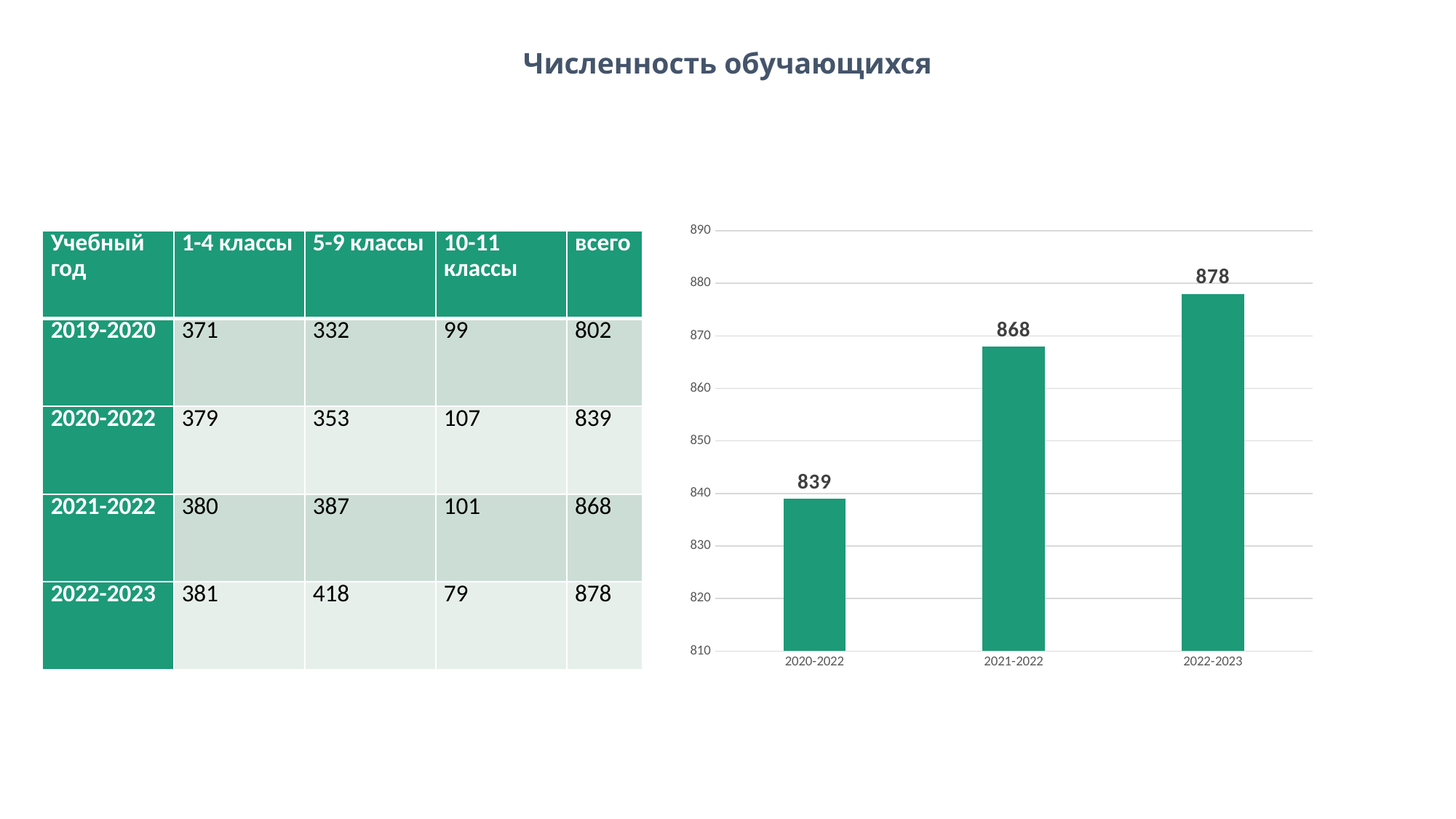
What is the value of the bar for 2022-2023 in the chart? 878 Do the values in the chart rise or fall from 2020-2022 to 2022-2023? rise Which category has the lowest bar in the chart? 2020-2022 What is the difference between the values for 2021-2022 and 2020-2022 in the chart? 29 What is the value of the bar for 2021-2022 in the chart? 868 Which is larger in the chart, the value for 2021-2022 or the value for 2022-2023? 2022-2023 What type of chart is shown on the slide? bar chart What is the difference between the values for 2022-2023 and 2020-2022 in the chart? 39 Is the value for 2021-2022 in the chart greater or less than 860? greater Which category has the highest bar in the chart? 2022-2023 What is the value of the bar for 2020-2022 in the chart? 839 How many bars are shown in the chart? 3